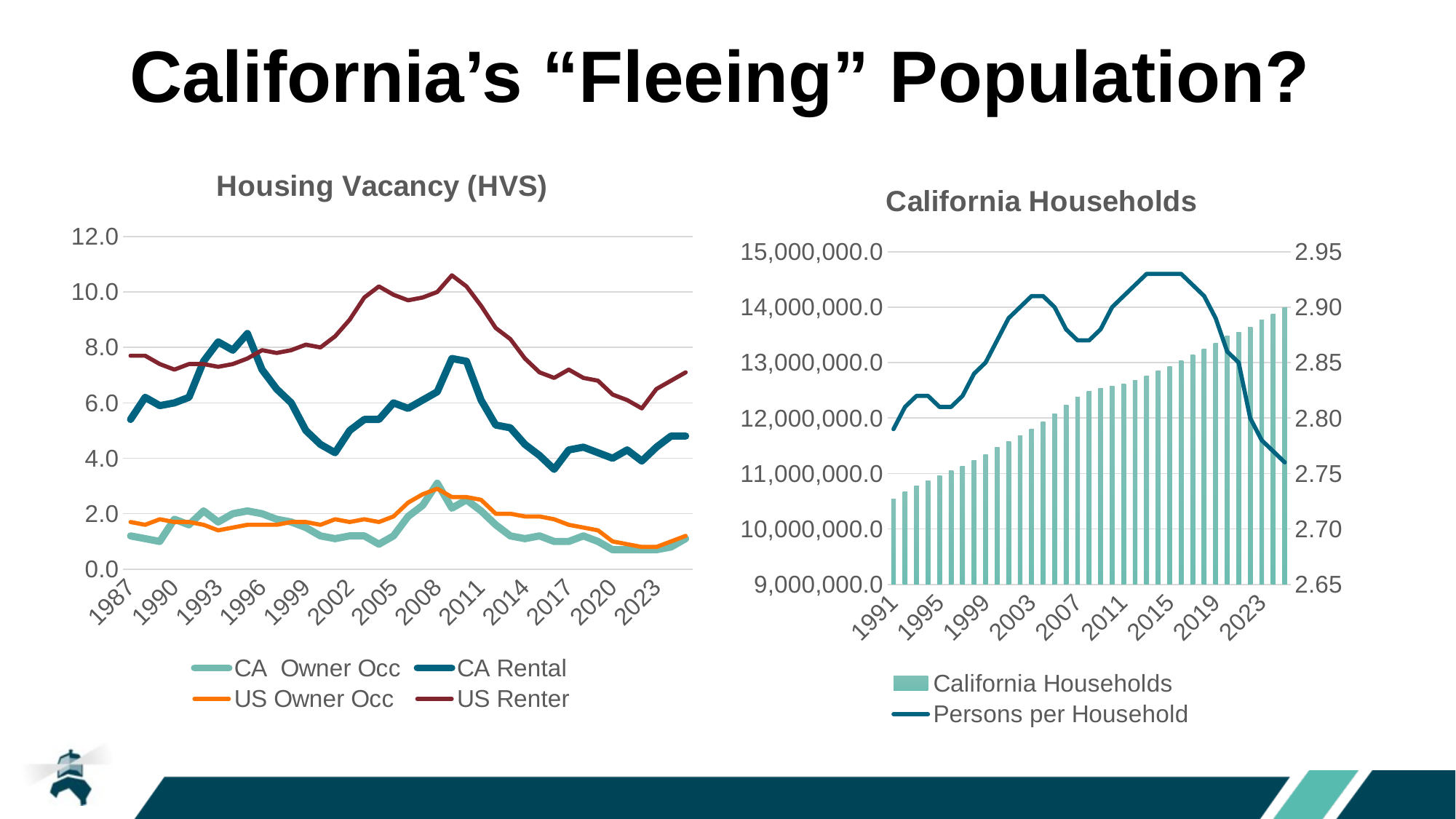
How many series does the legend of the Housing Vacancy (HVS) chart list? 4 In the Housing Vacancy (HVS) chart, which series has the highest value in 1987? US Renter What kind of chart is the Housing Vacancy (HVS) chart? line chart In the California Households chart, is the Persons per Household value in 2015 greater or less than 2.90? greater In the California Households chart, do the California Households bars rise or fall from 1991 to 2023? rise In the Housing Vacancy (HVS) chart, is the US Renter value in 2005 greater or less than 8.0? greater How many series does the legend of the California Households chart list? 2 In the California Households chart, is the California Households value in 1991 greater or less than 11,000,000.0? less In the Housing Vacancy (HVS) chart, around 2008, is the US Renter line higher or lower than the CA Rental line? higher In the Housing Vacancy (HVS) chart, does the CA Rental line rise or fall between 2008 and 2017? fall What is the title of the chart on the left of the slide? Housing Vacancy (HVS)